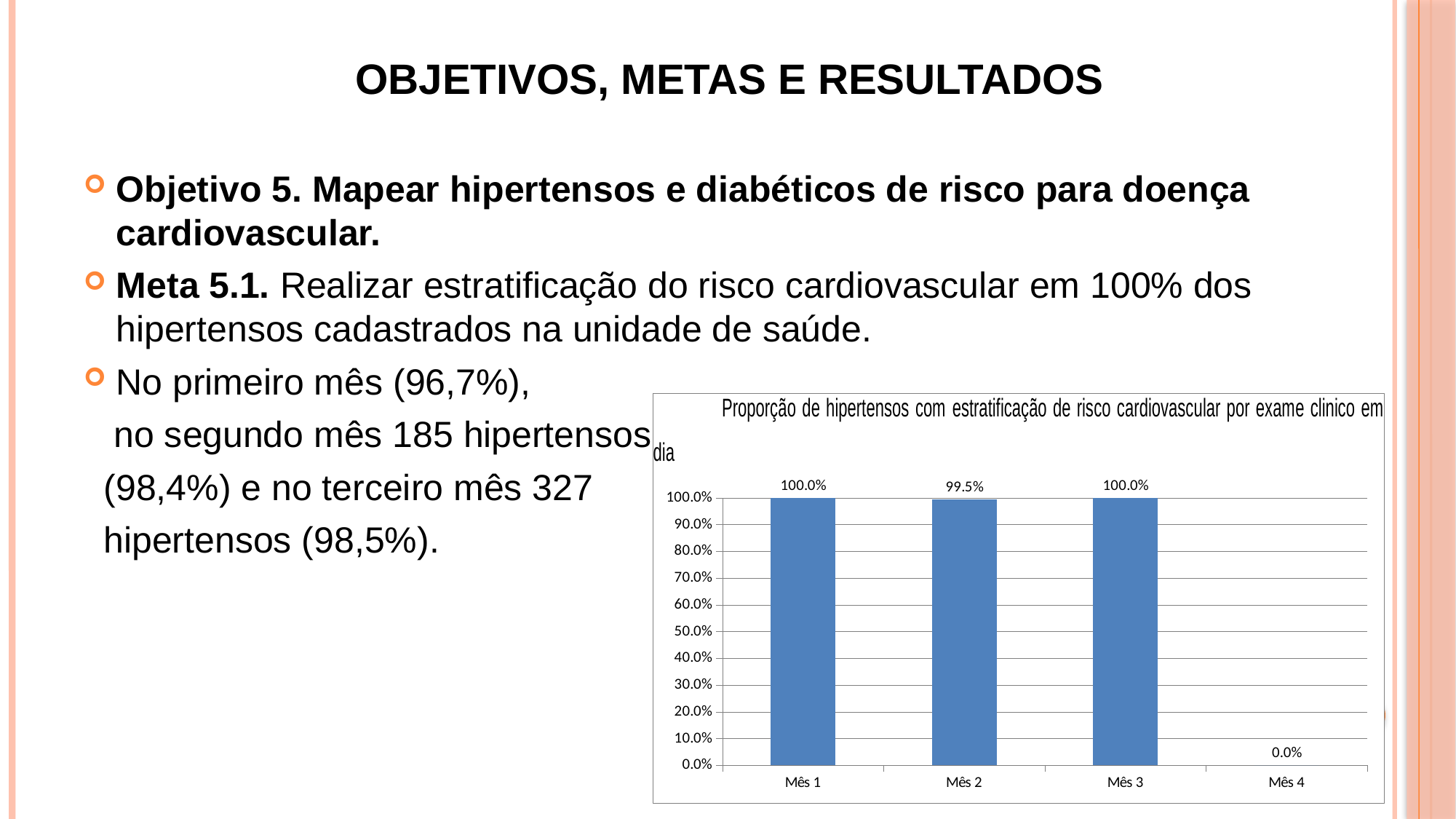
What is the difference between the values for Mês 1 and Mês 2? 0.5% What is the value for Mês 1? 100.0% What colour are the bars in the chart? Blue What is the value for Mês 3? 100.0% What is the value for Mês 2? 99.5% What kind of chart is shown on the slide? Bar chart Which month has the lowest value? Mês 4 Which is larger, the value for Mês 3 or the value for Mês 2? Mês 3 Is the value for Mês 2 greater or less than 90.0%? greater What is the difference between the values for Mês 3 and Mês 4? 100.0% How many months are shown on the x axis? 4 What is the value for Mês 4? 0.0%